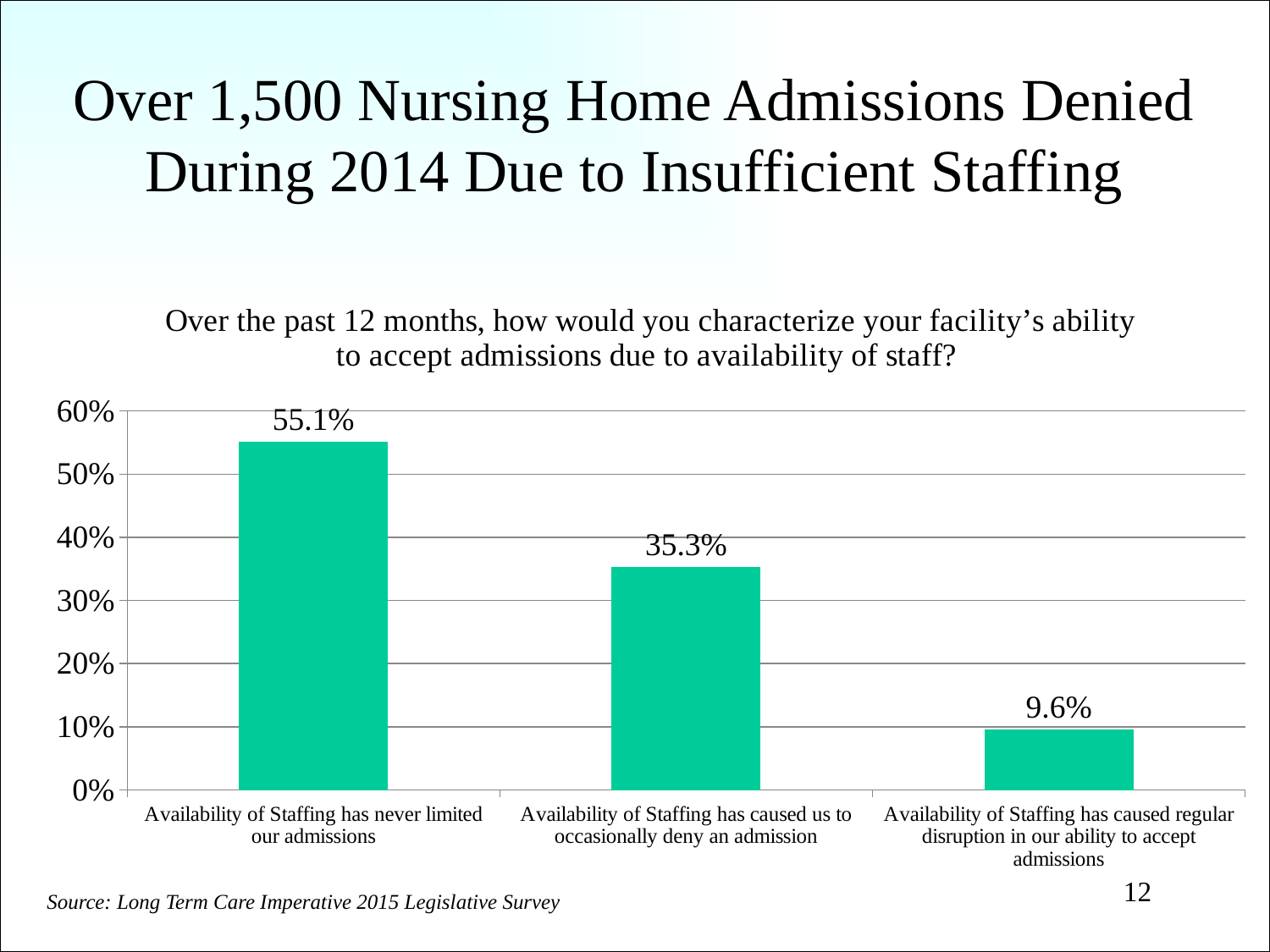
Which is larger: the percentage for 'occasionally deny an admission' or for 'caused regular disruption'? Availability of Staffing has caused us to occasionally deny an admission Which response category has the lowest percentage? Availability of Staffing has caused regular disruption in our ability to accept admissions How many response categories are shown in the chart? 3 Is the value for 'never limited our admissions' greater or less than 50%? greater What percentage of respondents said availability of staffing has caused regular disruption in their ability to accept admissions? 9.6% What is the difference in percentage points between 'occasionally deny an admission' and 'caused regular disruption'? 25.7 percentage points What percentage of respondents said availability of staffing has caused them to occasionally deny an admission? 35.3% Which response category has the highest percentage? Availability of Staffing has never limited our admissions What percentage of respondents said availability of staffing has never limited their admissions? 55.1% What is the source cited for the chart data? Long Term Care Imperative 2015 Legislative Survey What type of chart is shown on the slide? Bar chart What is the difference in percentage points between 'never limited our admissions' and 'occasionally deny an admission'? 19.8 percentage points